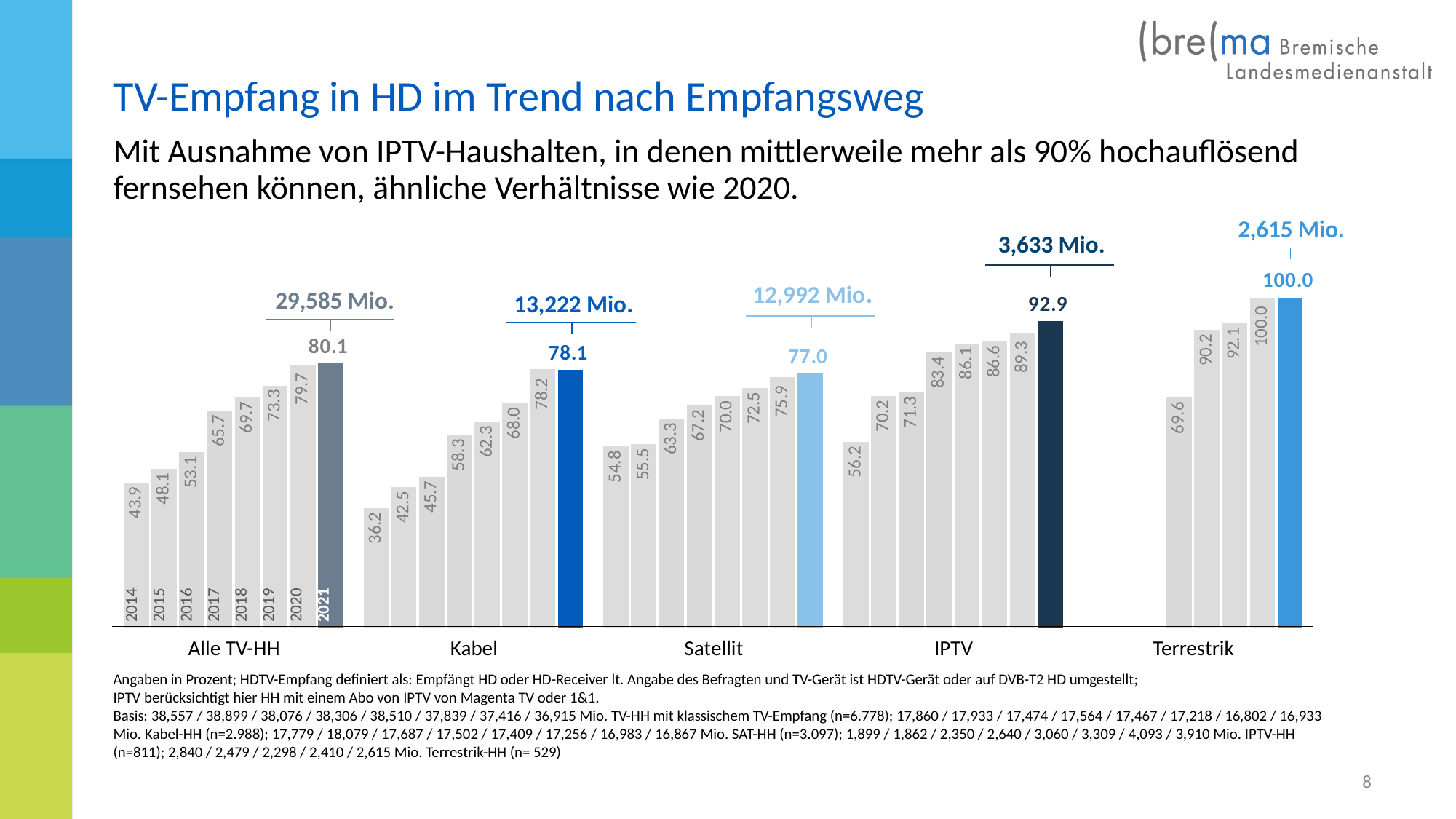
What kind of chart is shown on the slide? bar chart Which reception type (Empfangsweg) has the highest 2021 value? Terrestrik Which reception type has the lowest 2014 value? Kabel Do the values for Satellit rise or fall from 2014 to 2021? rise What household figure in Mio. is shown above the IPTV group? 3,633 Mio. What is the difference between the 2021 values for IPTV and Kabel? 14.8 What is the 2014 value for Kabel? 36.2 How many bars are shown for the Alle TV-HH group? 8 What is the 2021 value for IPTV? 92.9 What is the 2021 value for Satellit? 77.0 Which is larger, the 2021 value for Kabel or the 2021 value for Satellit? Kabel What is the 2021 value for Alle TV-HH? 80.1